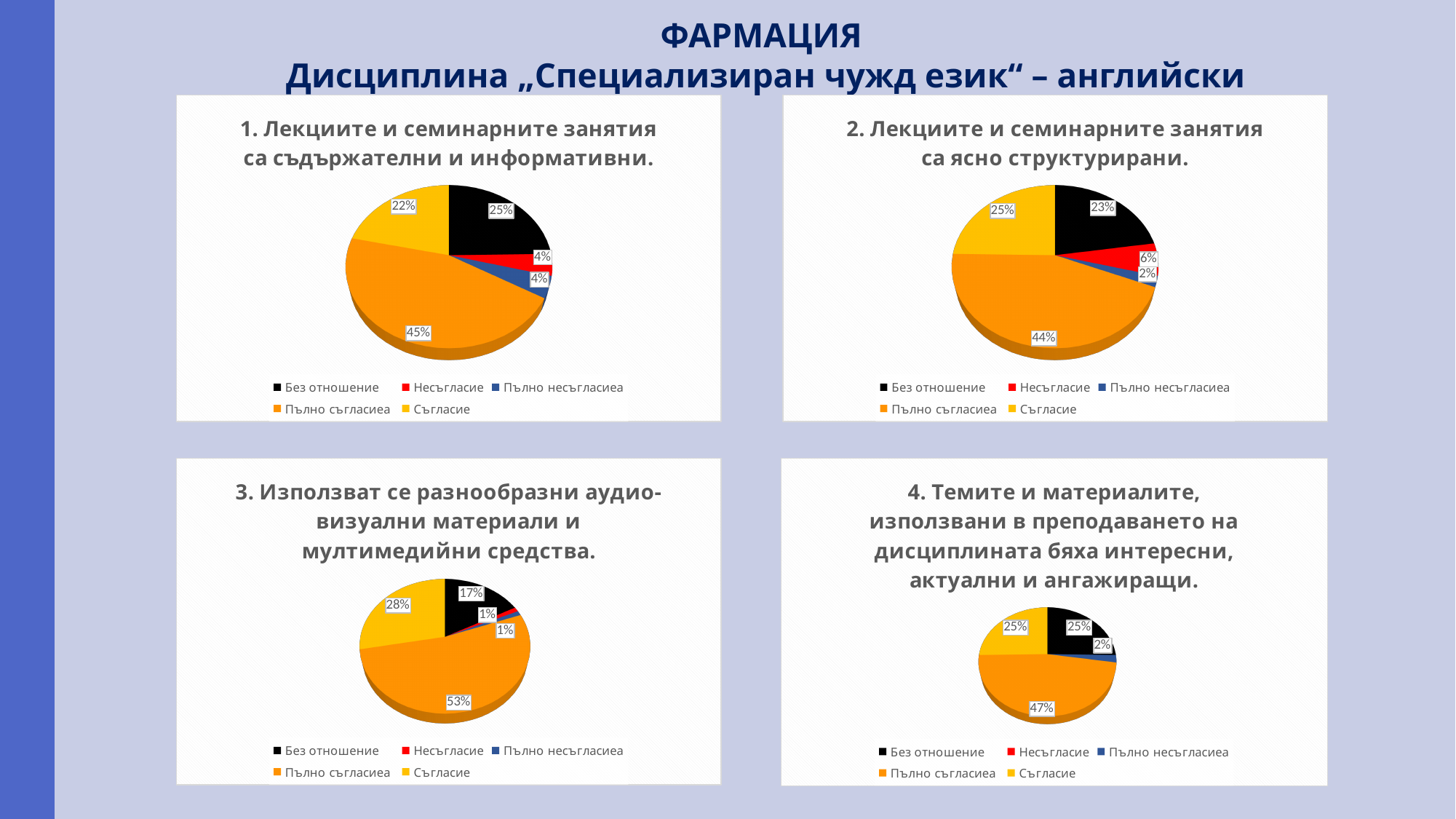
In the bottom-left chart (3. Използват се разнообразни аудио-визуални материали и мултимедийни средства), what percentage is shown for Без отношение? 17% In the top-right chart (2. Лекциите и семинарните занятия са ясно структурирани), what percentage is shown for Несъгласие? 6% In the top-left chart, what is the difference between the Без отношение share and the Съгласие share? 3% In the bottom-left chart, what is the difference between the Пълно съгласиеа share and the Съгласие share? 25% In the top-left chart (1. Лекциите и семинарните занятия са съдържателни и информативни), what share is labelled for Пълно съгласиеа? 45% In the top-right chart, which category has the largest slice? Пълно съгласиеа In the bottom-right chart (4. Темите и материалите...), what percentage is shown for Пълно съгласиеа? 47% How many entries does the legend of the top-right chart list? 5 In the top-right chart, which colour represents Съгласие? Yellow In the top-left chart, what percentage is shown for Съгласие? 22% In the bottom-right chart, which is larger: the share for Без отношение or the share for Пълно несъгласиеа? Без отношение What type of chart is used in the bottom-left panel? Pie chart